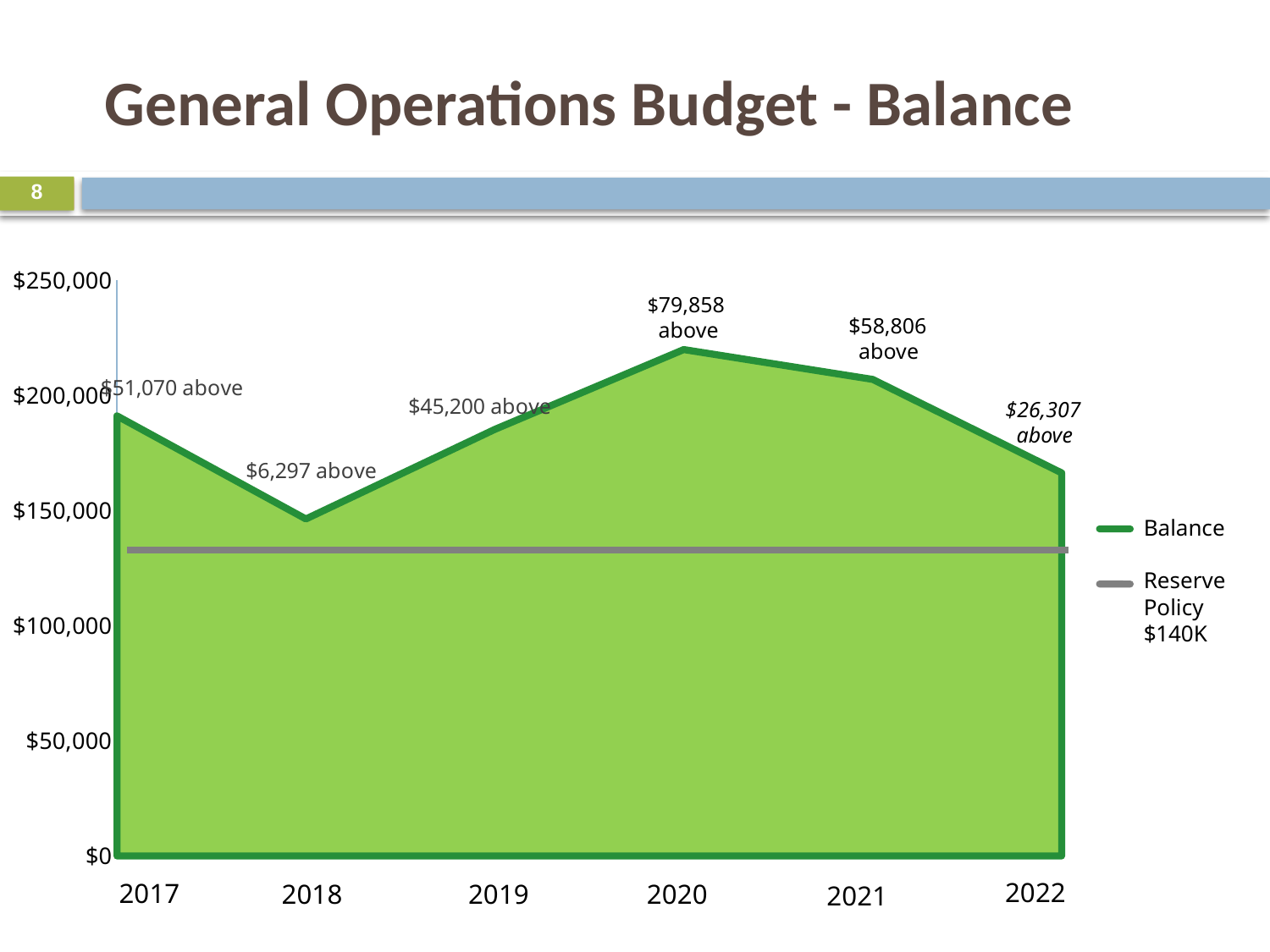
How many series does the legend list? 2 How many years are shown on the x axis? 6 Which year has a higher Balance, 2019 or 2018? 2019 What annotation is shown above the 2020 point on the Balance line? $79,858 above In which year is the Balance lowest? 2018 In which year is the Balance highest? 2020 Is the Balance for 2020 greater or less than $200,000? greater Is the Balance for 2022 greater or less than $150,000? greater What annotation is shown for 2018 on the Balance line? $6,297 above What annotation is shown for 2022 on the Balance line? $26,307 above Does the Balance rise or fall from 2020 to 2022? fall What annotation is shown for 2017 on the Balance line? $51,070 above